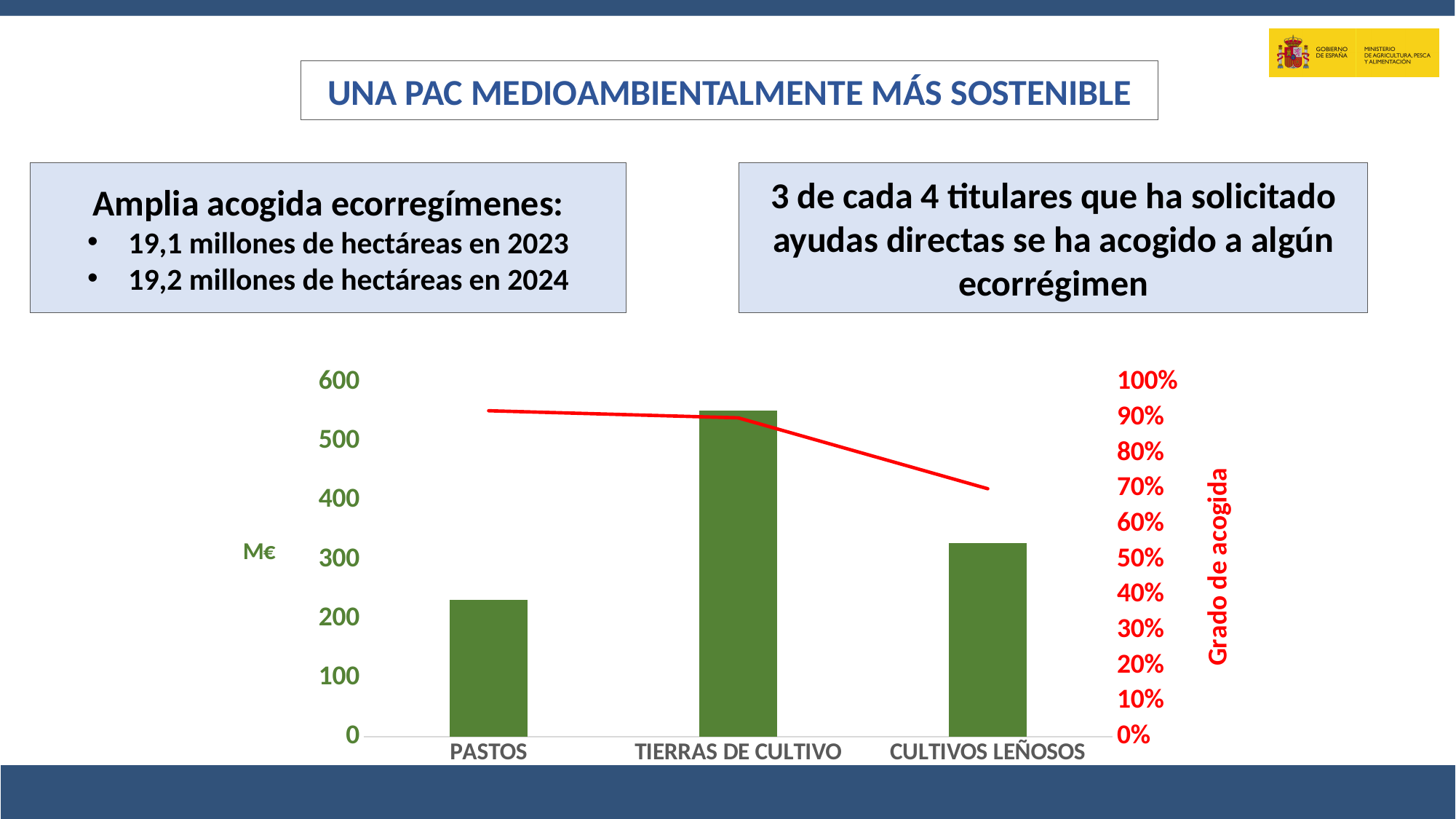
Does the red Grado de acogida line rise or fall from PASTOS to CULTIVOS LEÑOSOS? It falls Which bar is taller, CULTIVOS LEÑOSOS or PASTOS? CULTIVOS LEÑOSOS Is the bar value for CULTIVOS LEÑOSOS greater or less than 400? less Is the bar value for PASTOS greater or less than 300? less What kind of chart is shown on the slide? A bar chart combined with a line What unit is shown on the left vertical axis of the chart? M€ How many categories are shown on the x axis of the chart? 3 What is the label of the right vertical axis of the chart? Grado de acogida Which category has the tallest bar in the chart? TIERRAS DE CULTIVO Which category has the shortest bar in the chart? PASTOS Is the bar value for TIERRAS DE CULTIVO greater or less than 500? greater